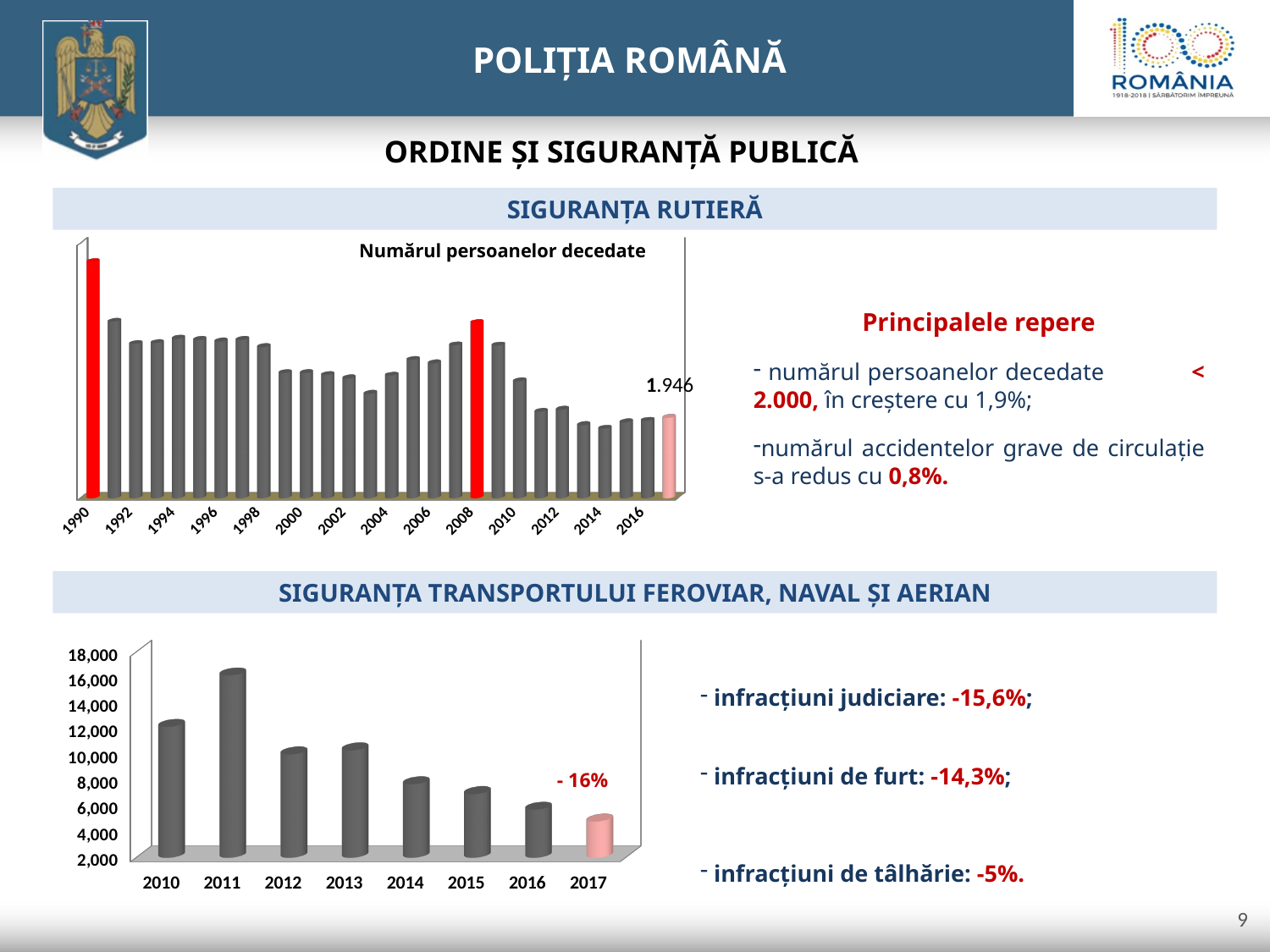
In the top chart 'Numărul persoanelor decedate', which is larger, the value for 2004 or the value for 2008? 2008 In the top chart 'Numărul persoanelor decedate', which year has the highest bar? 1990 In the bottom chart (2010–2017), which year has the highest bar? 2011 In the bottom chart, what percentage label is printed next to the 2017 bar? - 16% In the bottom chart, is the value for 2017 greater or less than 6,000? less In the bottom chart (2010–2017), which year has the lowest bar? 2017 In the top chart 'Numărul persoanelor decedate', which two years are drawn with red bars? 1990 and 2008 What kind of chart is the top chart 'Numărul persoanelor decedate'? Bar chart In the top chart 'Numărul persoanelor decedate', what value is labelled for 2017? 1.946 In the bottom chart, is the value for 2011 greater or less than 14,000? greater How many years are shown on the x axis of the bottom chart? 8 In the top chart 'Numărul persoanelor decedate', do the values rise or fall from 2008 to 2017? Fall